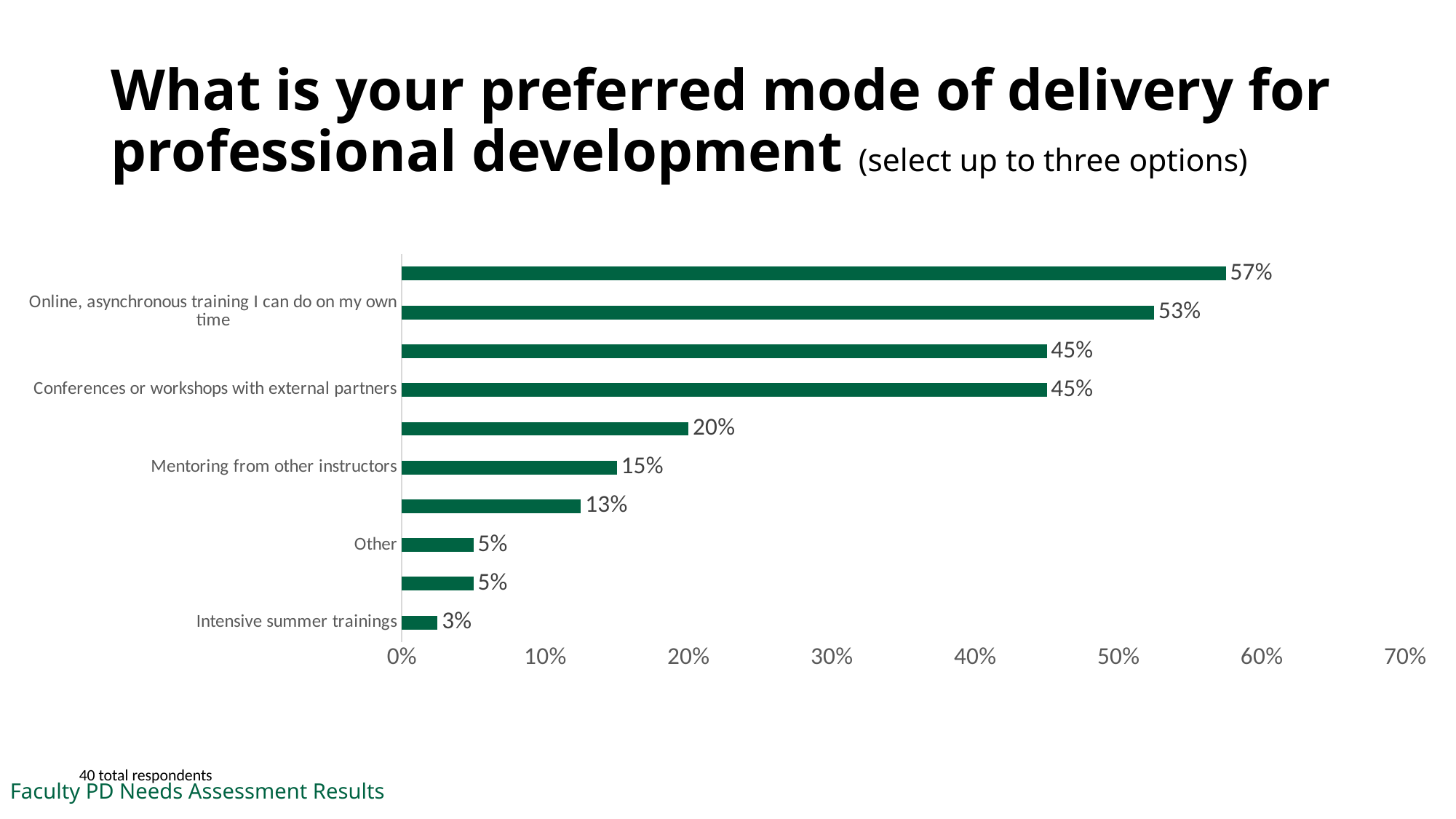
What is the value for 'Intensive summer trainings'? 3% What kind of chart is shown on the slide? Bar chart What is the highest value shown on the chart? 57% What percentage of respondents preferred 'Online, asynchronous training I can do on my own time'? 53% Which is larger: 'Conferences or workshops with external partners' or 'Mentoring from other instructors'? Conferences or workshops with external partners Is the value for 'Online, asynchronous training I can do on my own time' greater or less than 50%? greater Which labelled category has the lowest value? Intensive summer trainings How many bars are plotted on the chart? 10 What is the value for the 'Other' category? 5% What is the difference between 'Online, asynchronous training I can do on my own time' and 'Mentoring from other instructors'? 38% What percentage is shown for 'Mentoring from other instructors'? 15% What is the value for 'Conferences or workshops with external partners'? 45%